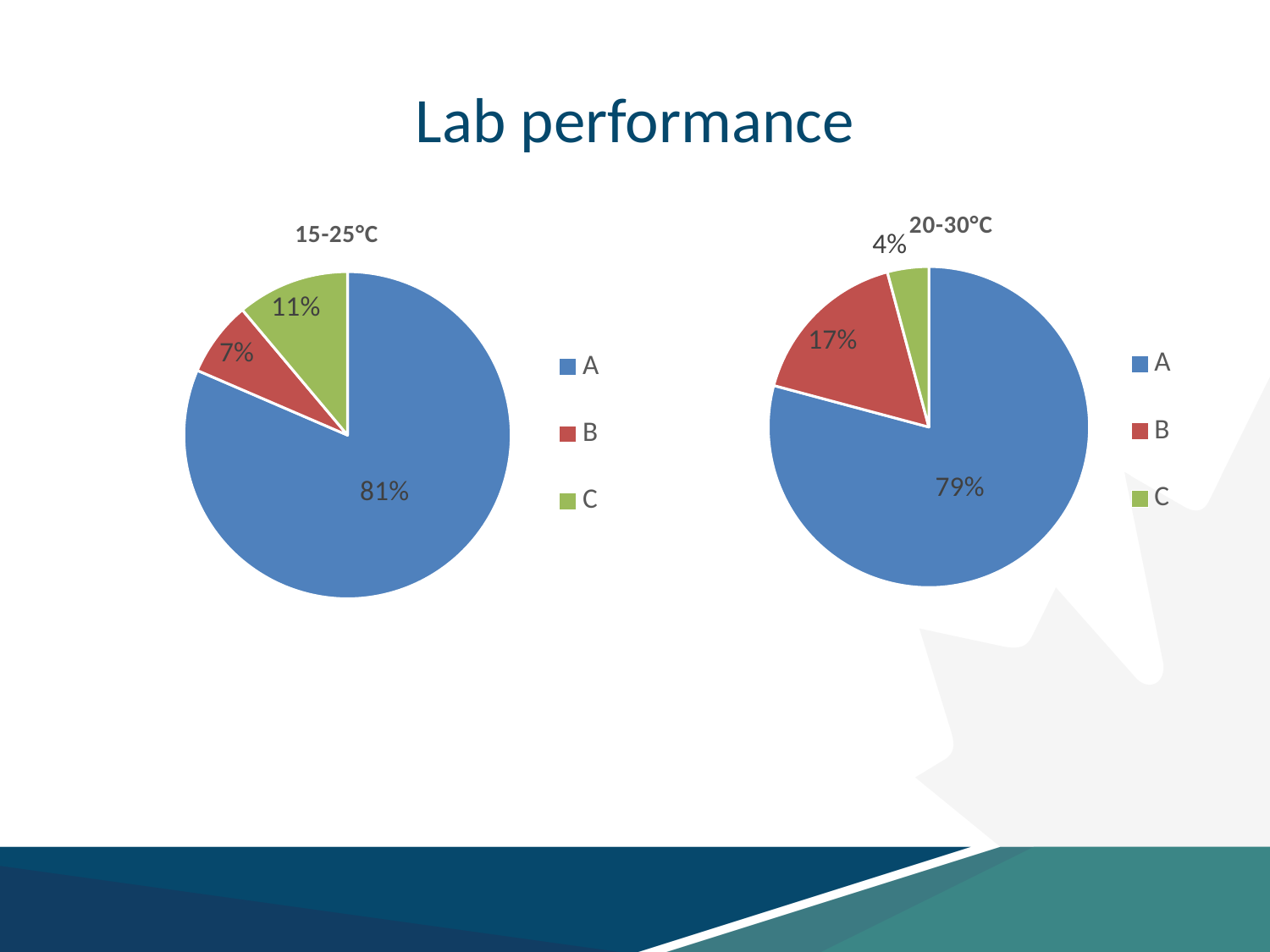
In the 15-25°C pie chart, what share does category B have? 7% Which is larger: the share of C in the 15-25°C chart or the share of C in the 20-30°C chart? 15-25°C How many categories does the legend of the 15-25°C chart list? 3 In the 20-30°C pie chart, what share does category A have? 79% What kind of chart is the 20-30°C chart? Pie chart In the 20-30°C pie chart, what share does category B have? 17% In the 20-30°C pie chart, what is the difference between the shares of B and C? 13% In the 15-25°C pie chart, which category has the smallest slice? B In the 20-30°C pie chart, which category has the largest slice? A